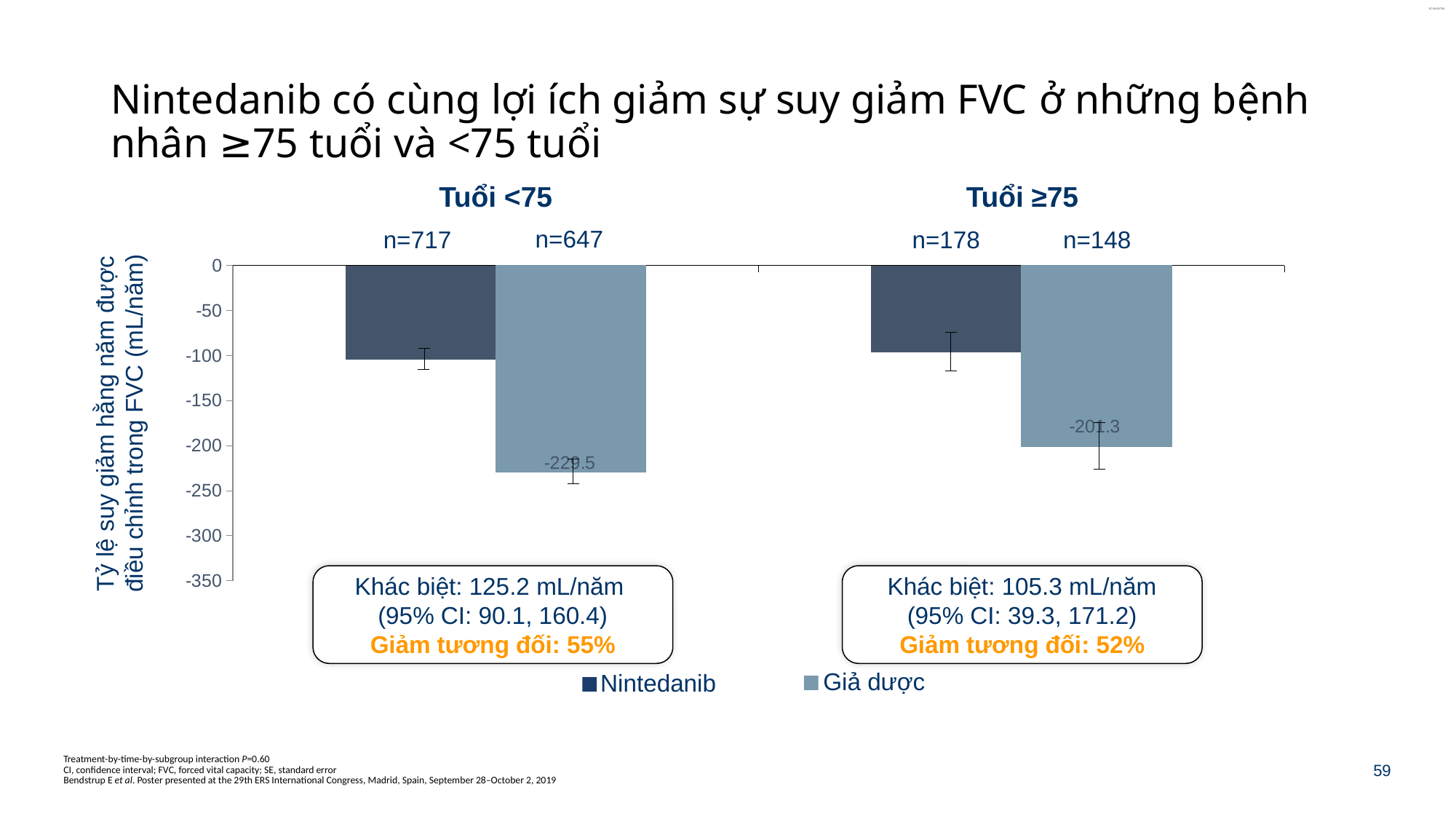
What is the sample size (n) for the Nintedanib group among patients aged <75? n=717 Is the value of the Nintedanib bar in the Tuổi ≥75 group greater or less than -50? less What is the lowest tick value shown on the y axis? -350 Which of the two Giả dược bars has the lower (more negative) value, Tuổi <75 or Tuổi ≥75? Tuổi <75 In the Tuổi <75 group, which bar extends further below zero, Nintedanib or Giả dược? Giả dược What is the value of the Giả dược bar in the Tuổi ≥75 group? -201.3 Is the value of the Nintedanib bar in the Tuổi <75 group greater or less than -150? greater What is the value of the Giả dược bar in the Tuổi <75 group? -229.5 How many series does the legend list? 2 How many age groups are shown on the chart? 2 What are the two series named in the legend? Nintedanib and Giả dược What kind of chart is shown on the slide? bar chart